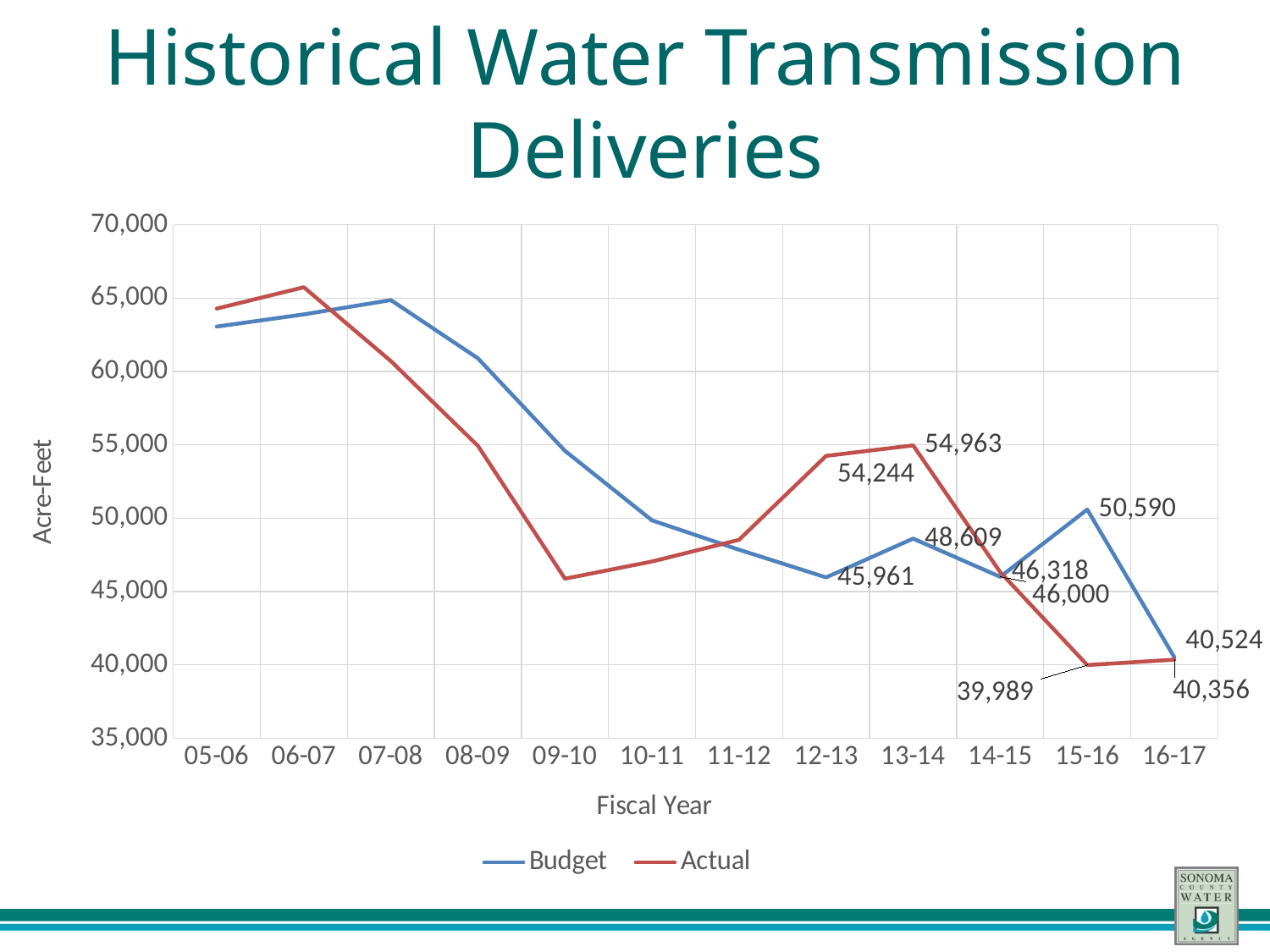
What is the Budget value for fiscal year 16-17? 40,524 What is the Actual value for fiscal year 15-16? 39,989 Is the Actual value for fiscal year 09-10 greater or less than 50,000? less What is the label on the y axis? Acre-Feet In fiscal year 12-13, which is larger, the Budget or the Actual value? Actual What is the Budget value for fiscal year 15-16? 50,590 What type of chart is shown on the slide? Line chart How many fiscal years are plotted along the x axis? 12 What is the difference between the Budget and Actual values in fiscal year 16-17? 168 What is the difference between the Budget and Actual values in fiscal year 15-16? 10,601 What is the Actual value for fiscal year 13-14? 54,963 How many series does the legend list? 2